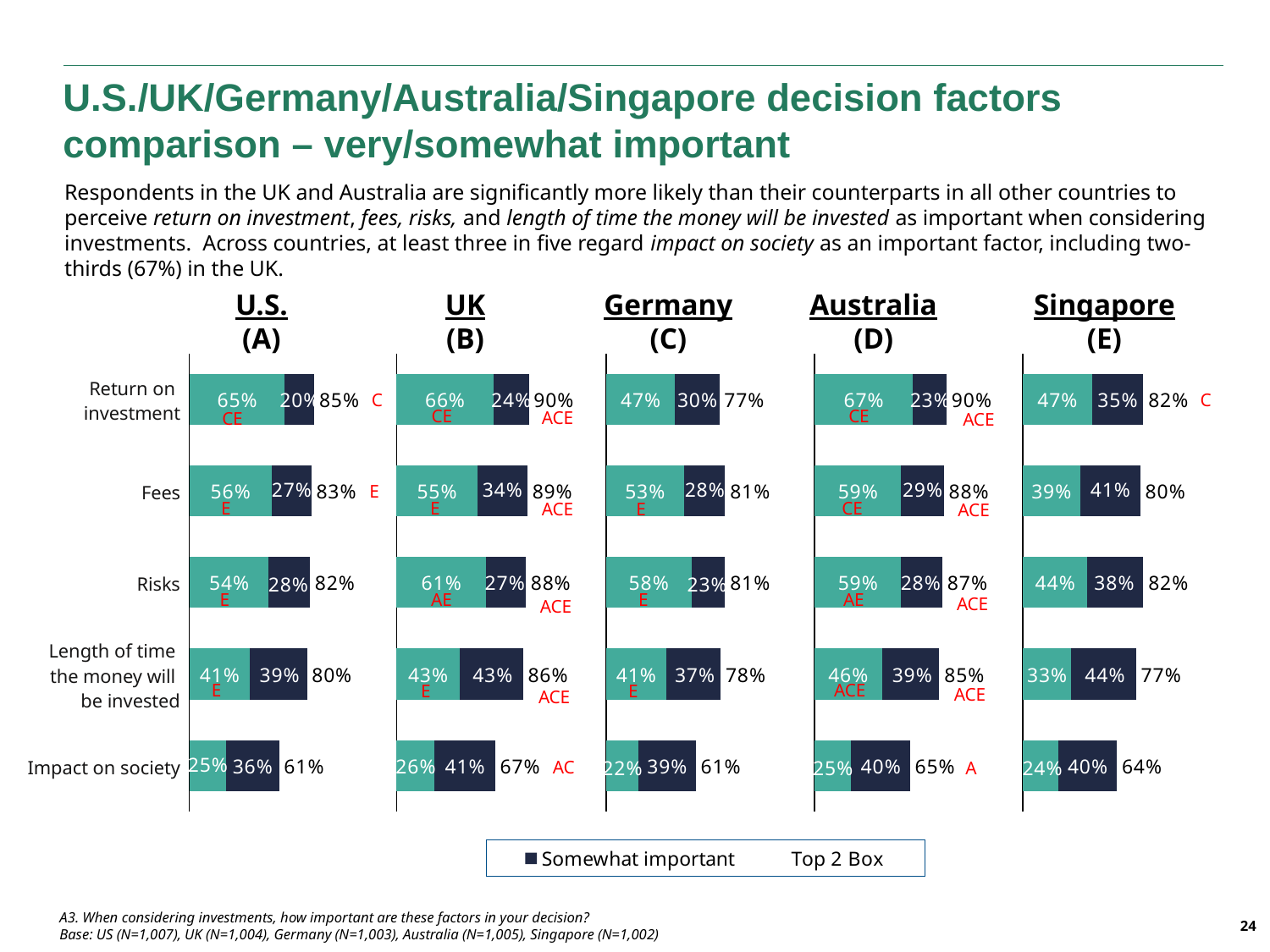
In the Singapore (E) chart, what is the Somewhat important value for Length of time the money will be invested? 44% How many decision factors are listed in each country chart? 5 Which is larger: the Top 2 Box value for Fees in the U.S. (A) chart or in the Singapore (E) chart? U.S. (A) In the UK (B) chart, what is the Top 2 Box value for Fees? 89% In the U.S. (A) chart, what is the Top 2 Box value for Return on investment? 85% In the Australia (D) chart, what is the total of the stacked bar for Risks? 87% What is the difference between the Top 2 Box value for Return on investment in the UK (B) chart and in the Germany (C) chart? 13 percentage points In the Germany (C) chart, which factor has the lowest Top 2 Box value? Impact on society What kind of chart is used for each country on this slide? Stacked bar chart In the Australia (D) chart, which factor has the highest Top 2 Box value? Return on investment How many country charts are shown on the slide? 5 In the Germany (C) chart, what is the first (left) segment value for Risks? 58%